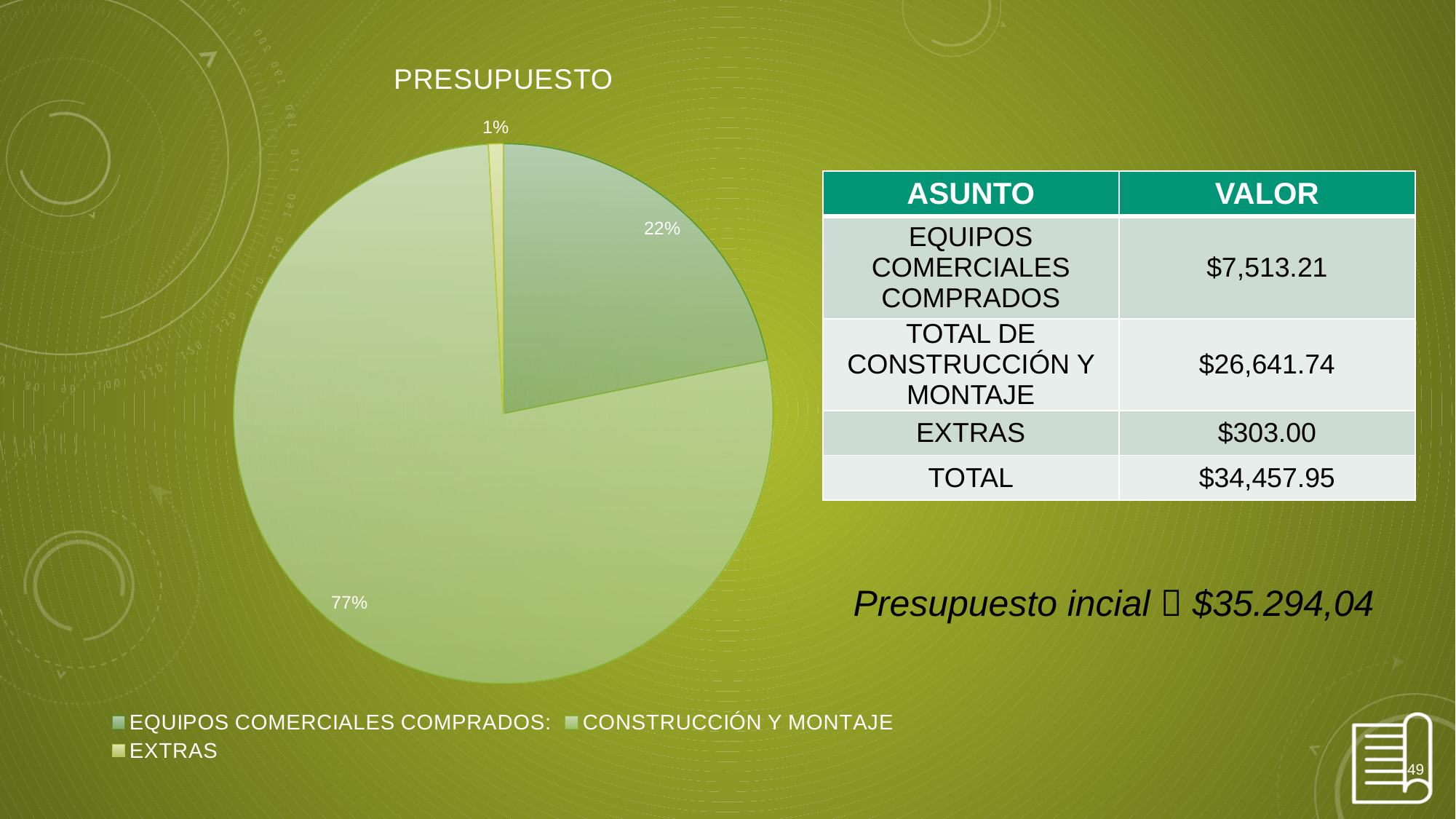
What share of the pie does EQUIPOS COMERCIALES COMPRADOS represent? 22% Which slice is larger, EQUIPOS COMERCIALES COMPRADOS or EXTRAS? EQUIPOS COMERCIALES COMPRADOS By how many percentage points does the CONSTRUCCIÓN Y MONTAJE slice exceed the EQUIPOS COMERCIALES COMPRADOS slice? 55 percentage points Which legend entry is listed first in the chart legend? EQUIPOS COMERCIALES COMPRADOS What kind of chart is shown on the slide? pie chart What share of the pie does CONSTRUCCIÓN Y MONTAJE represent? 77% How many entries does the chart legend list? 3 What share of the pie does EXTRAS represent? 1% Which category has the smallest slice of the pie? EXTRAS How many slices does the pie chart have? 3 Which category has the largest slice of the pie? CONSTRUCCIÓN Y MONTAJE What is the title of the chart? PRESUPUESTO